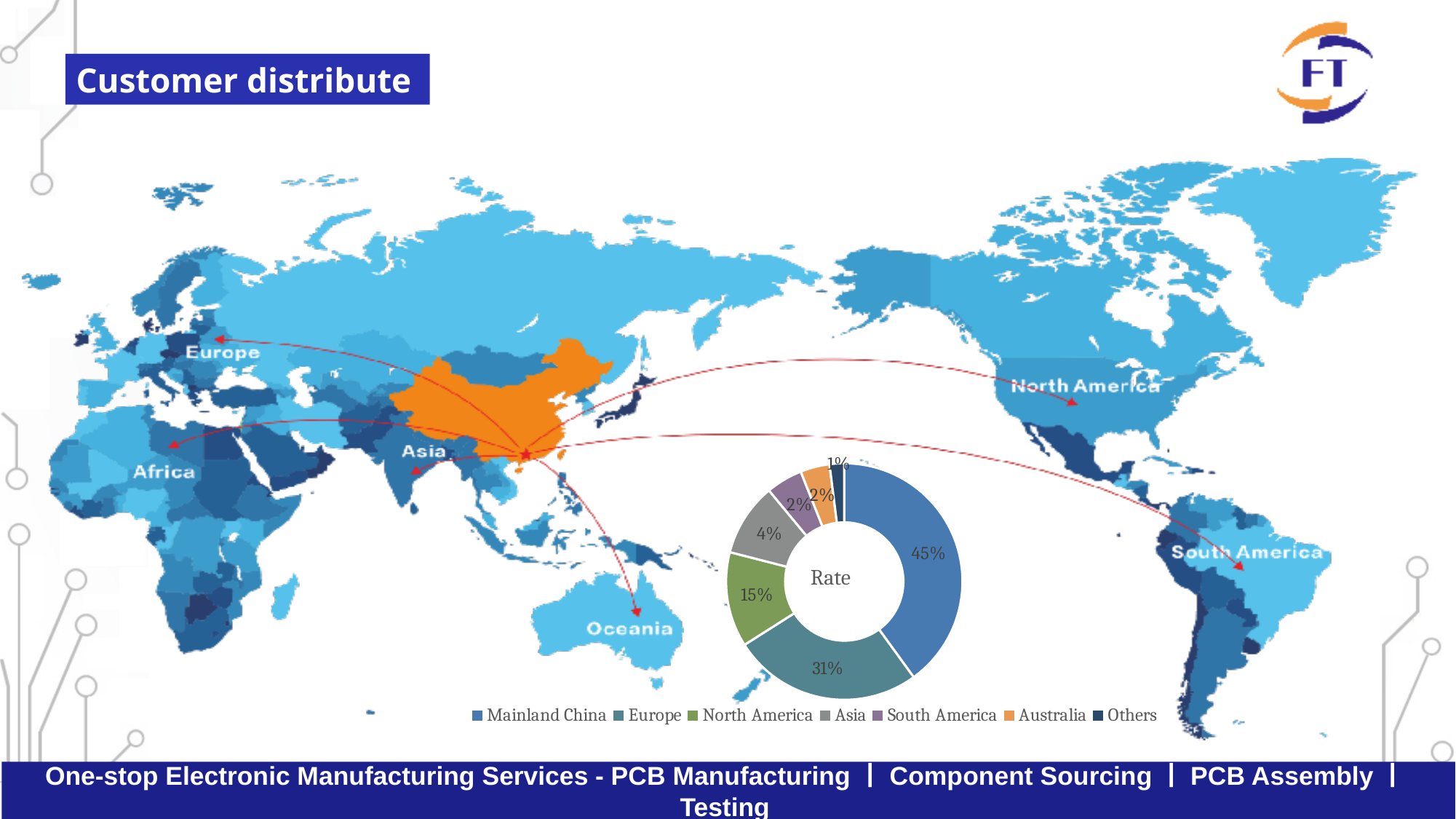
What percentage is shown for Asia in the doughnut chart? 4% What type of chart is shown on the slide? Doughnut chart Which is larger in the doughnut chart, the share for Europe or the share for North America? Europe What is the combined share of South America and Australia in the doughnut chart? 4% What is the value shown for North America in the doughnut chart? 15% How many categories does the legend of the doughnut chart list? 7 Which region has the largest share in the doughnut chart? Mainland China What percentage does the Europe slice show in the doughnut chart? 31% What label appears in the centre of the doughnut chart? Rate What is the difference in percentage points between Mainland China and Europe in the doughnut chart? 14 What share of customers is from Mainland China according to the doughnut chart? 45% Which category has the smallest share in the doughnut chart? Others